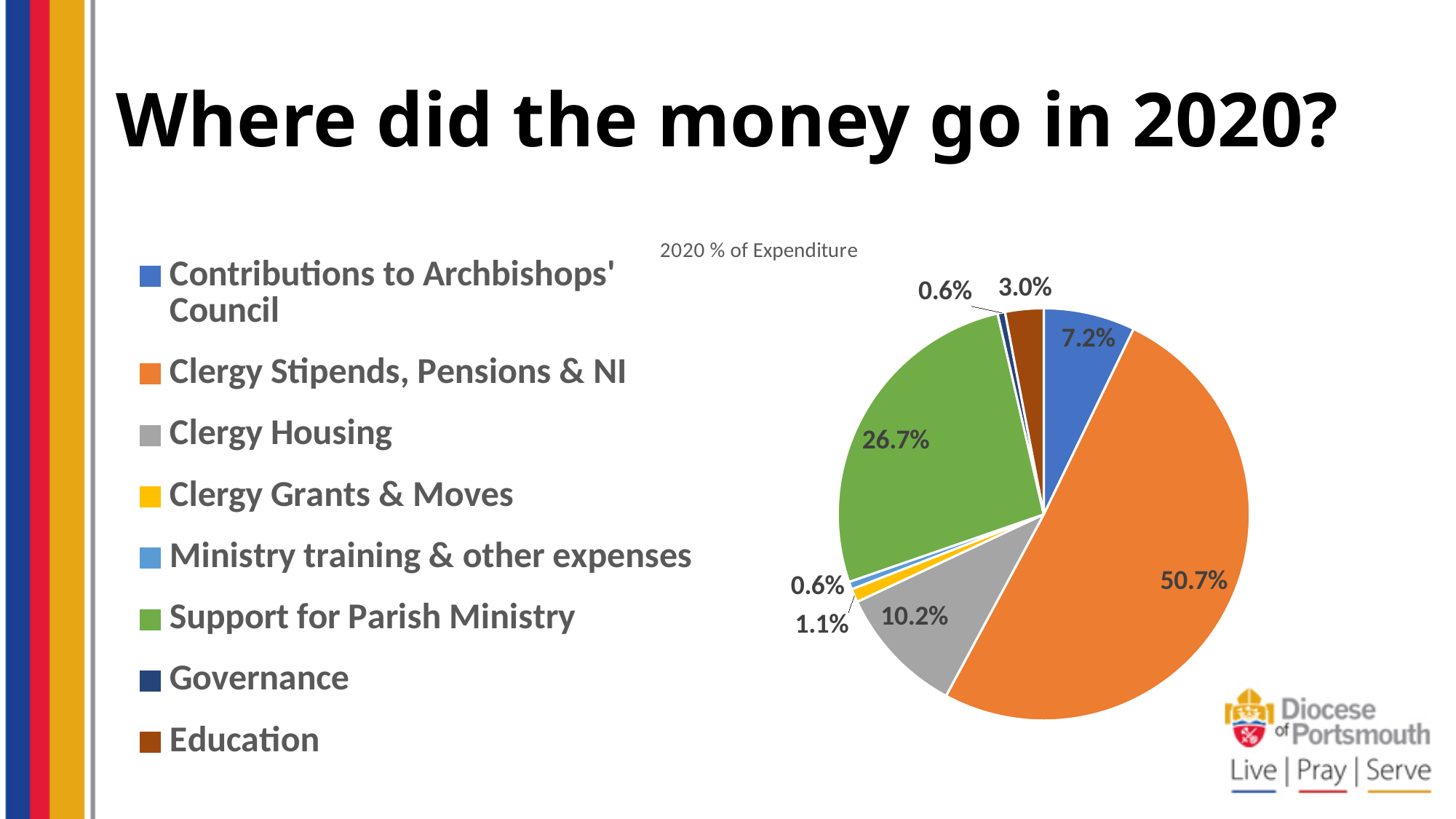
What share of expenditure went to Support for Parish Ministry? 26.7% Which is larger: the share for Clergy Housing or the share for Contributions to Archbishops' Council? Clergy Housing What is the difference in percentage points between Clergy Stipends, Pensions & NI and Support for Parish Ministry? 24.0% What share of expenditure went to Contributions to Archbishops' Council? 7.2% How many categories does the legend list? 8 What share of expenditure went to Clergy Grants & Moves? 1.1% What is the title of the chart? 2020 % of Expenditure What kind of chart is shown on the slide? Pie chart Which category accounts for the largest share of expenditure? Clergy Stipends, Pensions & NI What share of expenditure went to Clergy Housing? 10.2% What share of expenditure went to Education? 3.0% What share of expenditure went to Clergy Stipends, Pensions & NI? 50.7%